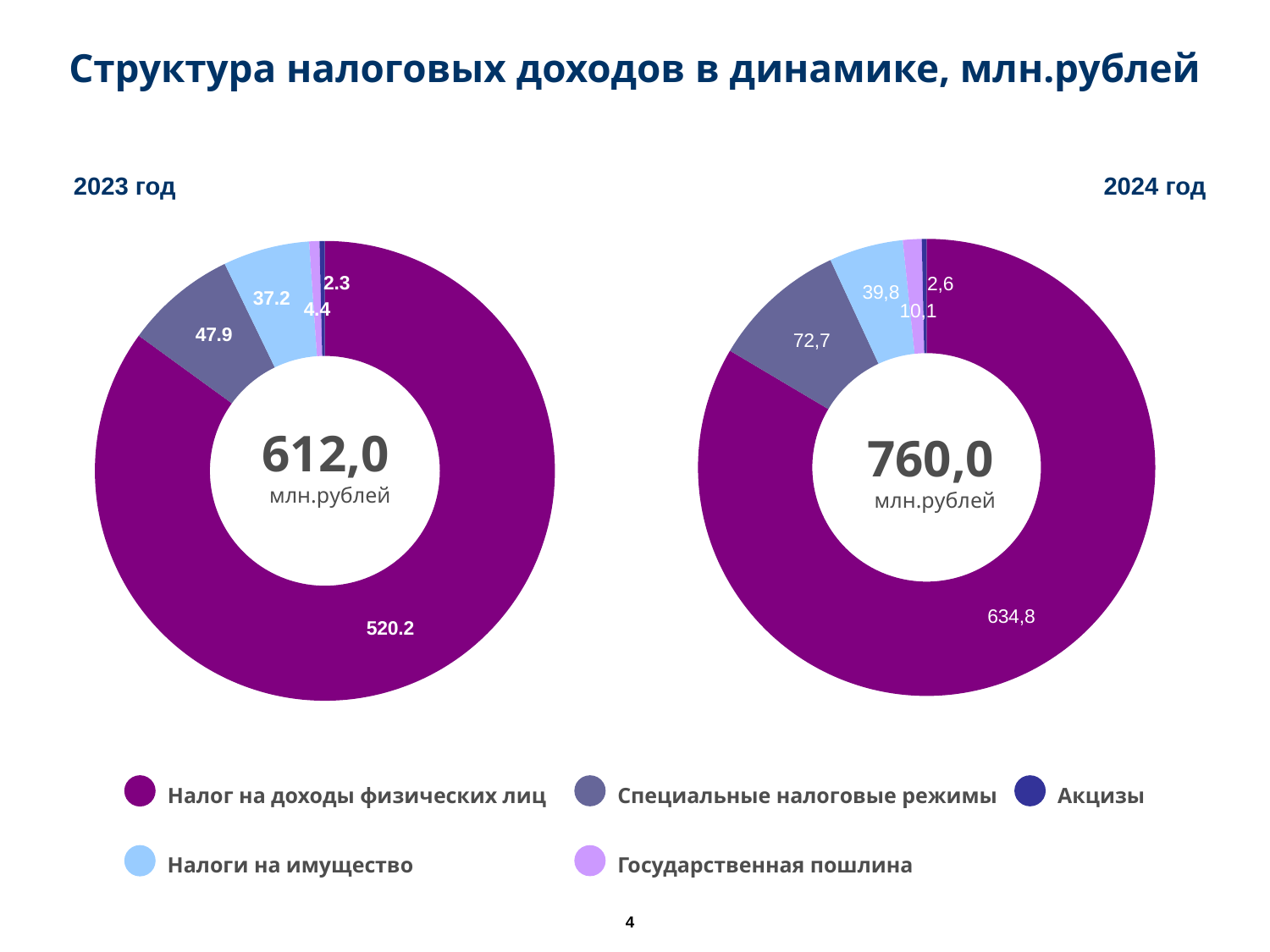
What kind of chart is used for the 2023 and 2024 data? Donut (pie) chart How many categories does the legend list for the charts? 5 On the 2024 chart, what is the value for Налог на доходы физических лиц? 634,8 Is the value for Специальные налоговые режимы larger on the 2023 chart or the 2024 chart? 2024 On the 2024 chart, what is the value for Специальные налоговые режимы? 72,7 On the 2023 chart, what is the value for Налог на доходы физических лиц? 520.2 Which legend entry is shown in dark blue? Акцизы On the 2023 chart, what is the total shown in the centre of the donut? 612,0 млн.рублей On the 2024 chart, what is the value for Налоги на имущество? 39,8 On the 2023 chart, what is the value for Специальные налоговые режимы? 47.9 On the 2024 chart, which category has the largest slice? Налог на доходы физических лиц By how much did the value for Налог на доходы физических лиц increase from the 2023 chart to the 2024 chart? 114.6